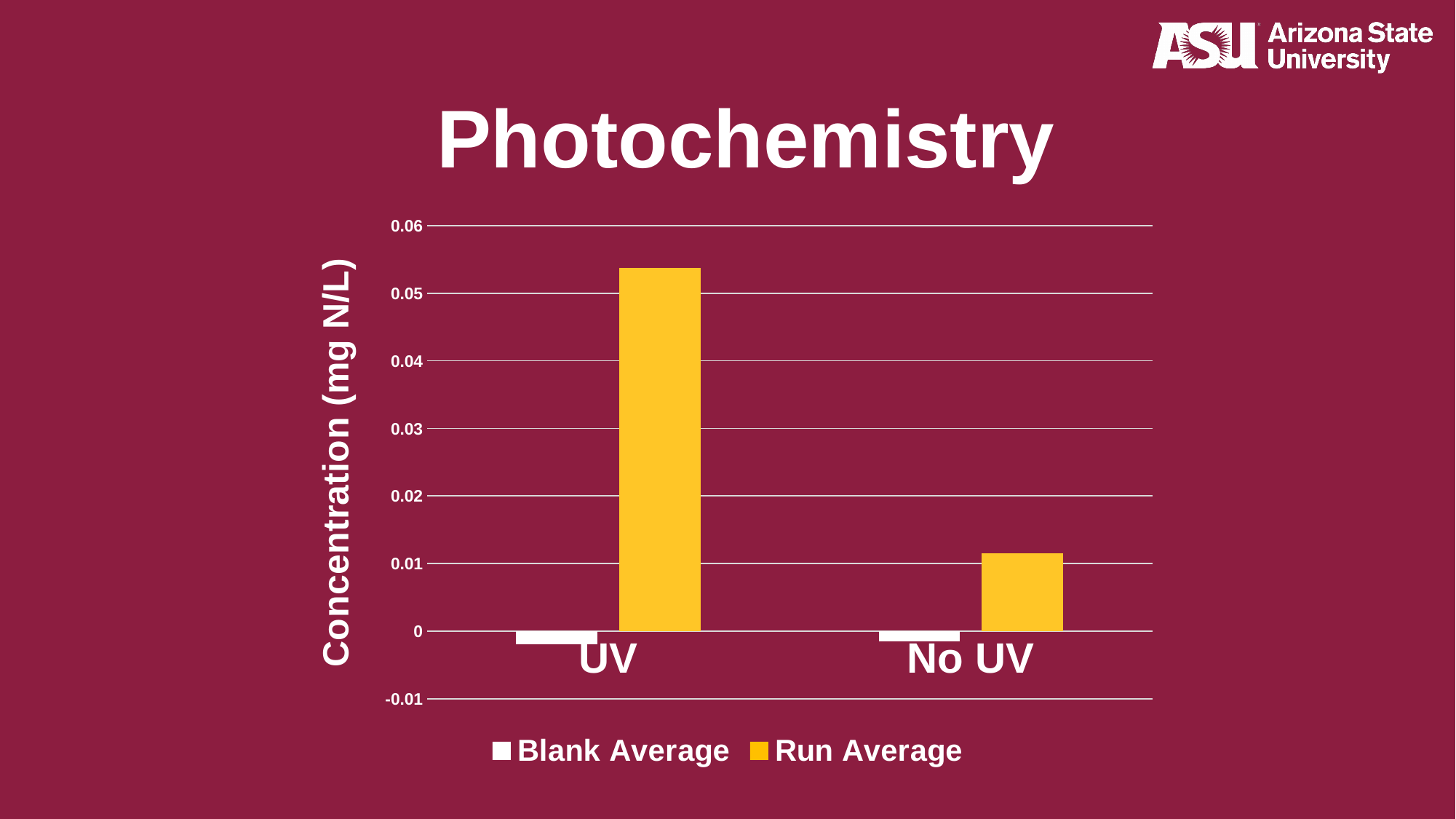
Which category has the highest Run Average value? UV What kind of chart is shown on the slide? bar chart What is the label on the chart's y axis? Concentration (mg N/L) How many series does the chart's legend list? 2 Is the Blank Average value for UV greater or less than 0? less Which category has the higher Run Average, UV or No UV? UV How many categories are shown on the x axis of the chart? 2 Is the Run Average value for UV greater or less than 0.05? greater Is the Run Average value for No UV greater or less than 0.02? less What are the two series named in the chart's legend? Blank Average and Run Average Does the Run Average rise or fall from UV to No UV? fall